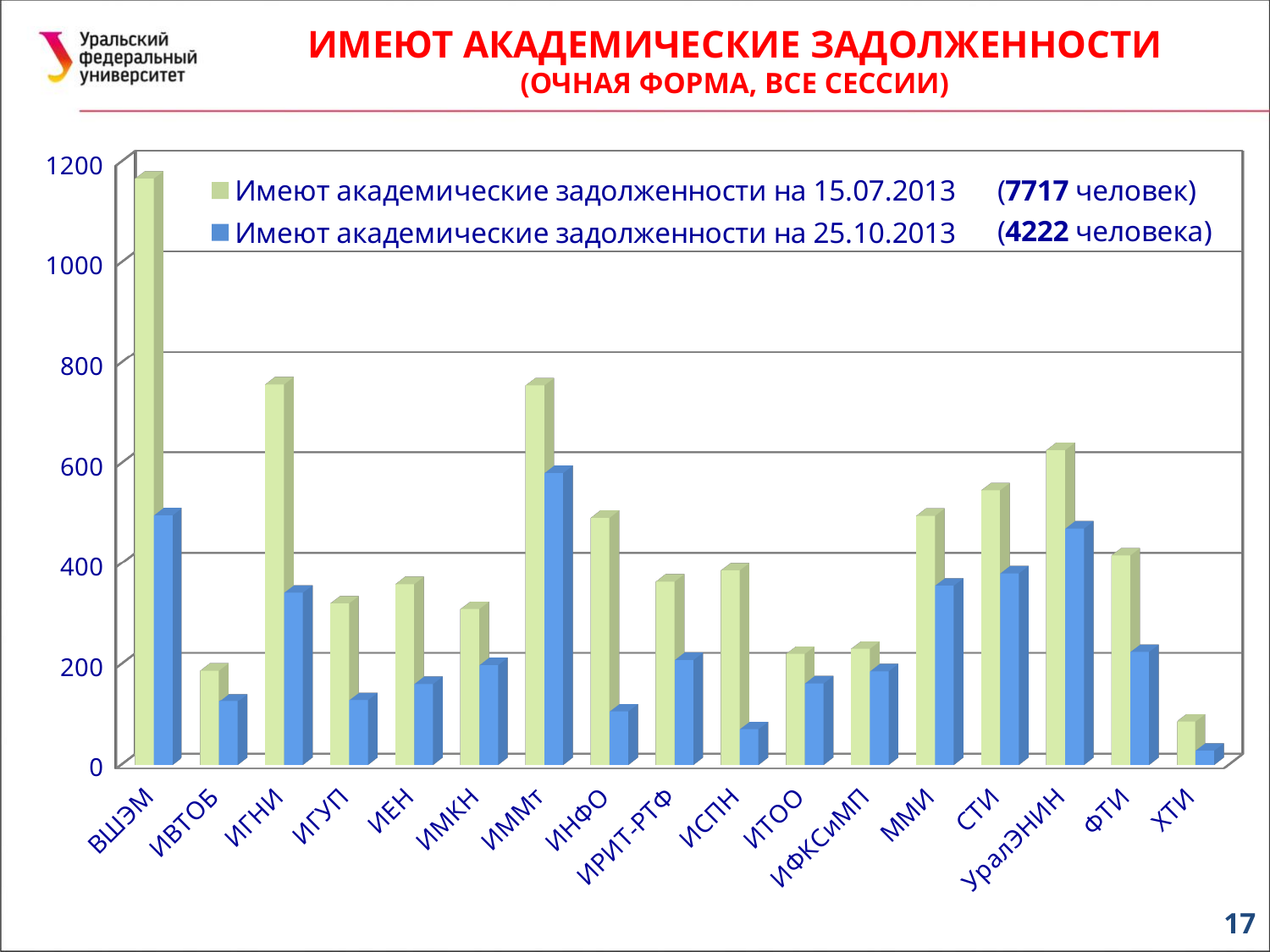
Is the value for ВШЭМ on 15.07.2013 greater or less than 1000? greater How many institutes (categories) are shown on the x axis? 17 Which is larger: the 15.07.2013 value for СТИ or for УралЭНИН? УралЭНИН According to the legend, how many people had academic debts on 25.10.2013 in total? 4222 человека Which institute has the lowest value for 'Имеют академические задолженности на 15.07.2013'? ХТИ Which institute has the highest value for 'Имеют академические задолженности на 25.10.2013'? ИММт How many series does the legend list? 2 Which is larger: the 25.10.2013 value for ВШЭМ or for ИММт? ИММт Which institute has the highest value for 'Имеют академические задолженности на 15.07.2013'? ВШЭМ Is the value for ИГНИ on 15.07.2013 greater or less than 800? less What kind of chart is shown on the slide? bar chart Is the value for ИСПН on 25.10.2013 greater or less than 200? less